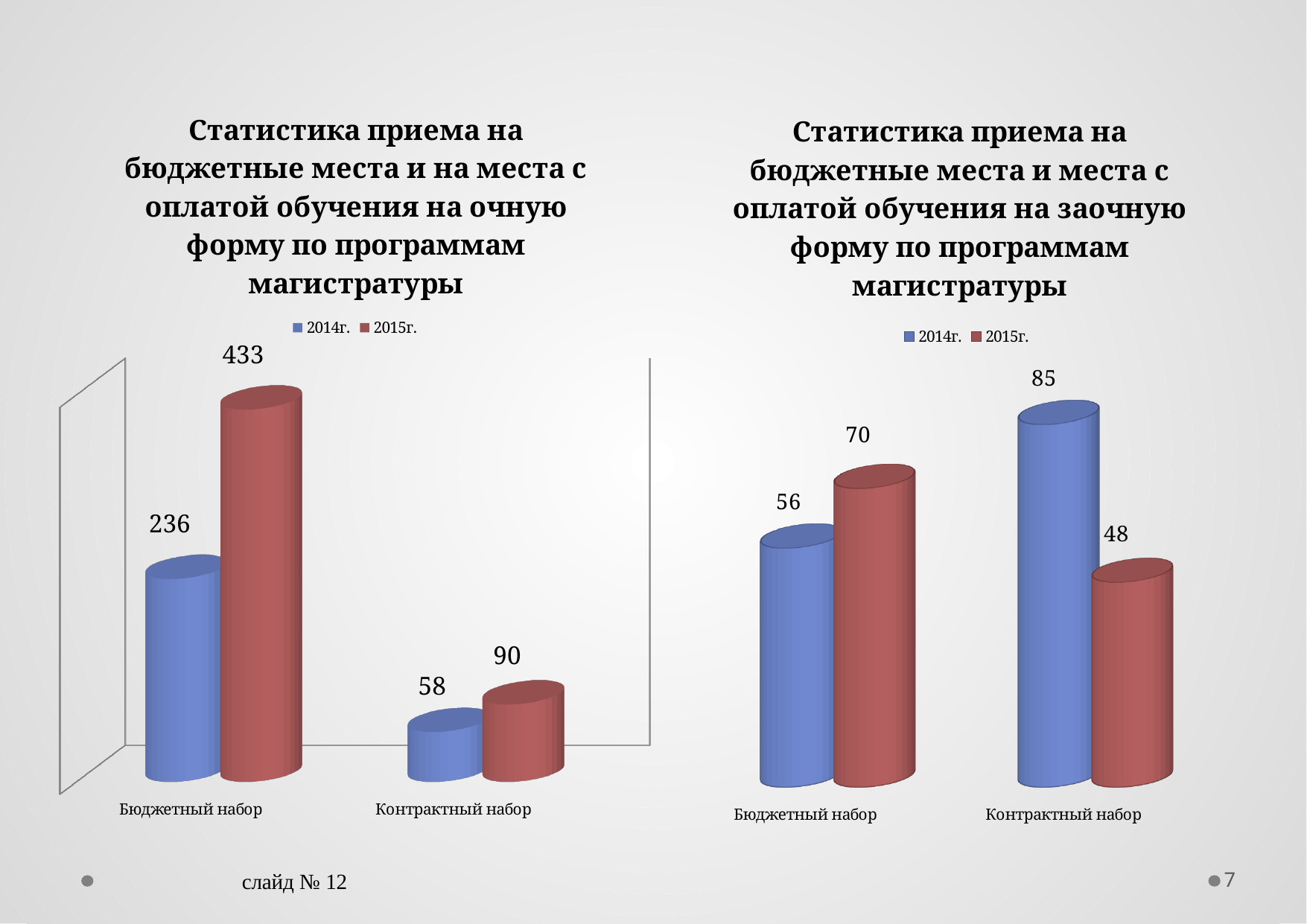
How many series does the legend of the left chart (очную форму) list? 2 How many categories are shown on the x axis of the right chart (заочную форму)? 2 In the right chart (заочную форму), which is larger for Бюджетный набор: the 2014г. value or the 2015г. value? 2015г. In the left chart (очную форму), what is the value for Контрактный набор in 2014г.? 58 In the left chart (очную форму), what is the value for Бюджетный набор in 2015г.? 433 In the left chart (очную форму), what is the difference between the 2015г. and 2014г. values for Бюджетный набор? 197 In the left chart (очную форму), which category has the highest value in 2015г.? Бюджетный набор In the right chart (заочную форму), what is the value for Контрактный набор in 2014г.? 85 In the right chart (заочную форму), what is the difference between the 2014г. and 2015г. values for Контрактный набор? 37 What kind of chart is the left chart (очную форму)? Bar chart In the right chart (заочную форму), which category has the lowest value in 2015г.? Контрактный набор In the right chart (заочную форму), what is the value for Бюджетный набор in 2015г.? 70